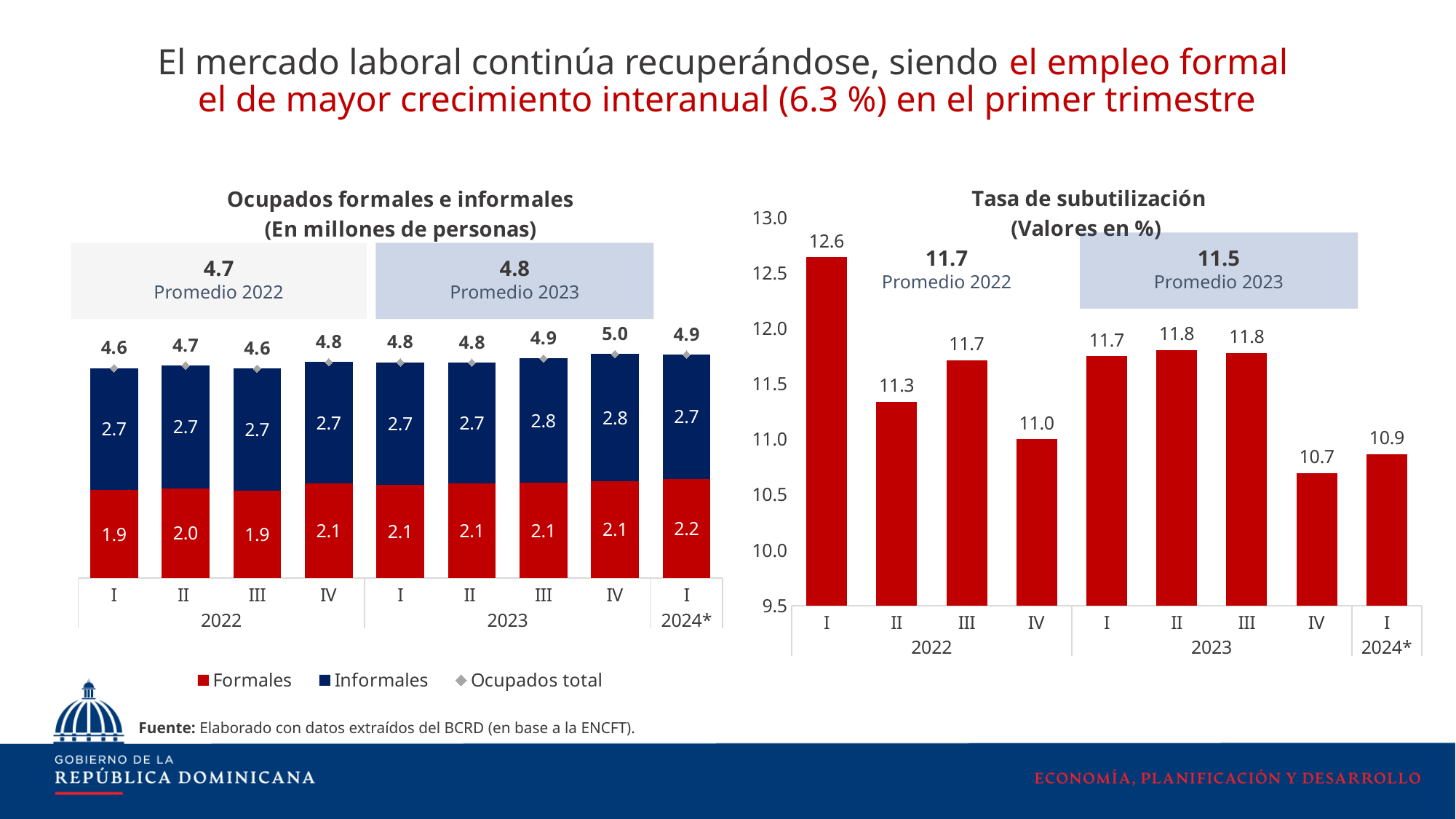
In the 'Tasa de subutilización' chart, how many quarters are plotted? 9 In the 'Ocupados formales e informales' chart, what is the difference between the Informales and Formales values in quarter I of 2022? 0.8 In the 'Ocupados formales e informales' chart, how many series does the legend list? 3 In the 'Tasa de subutilización' chart, what is the value for quarter I of 2024*? 10.9 In the 'Tasa de subutilización' chart, what is the difference between quarter I of 2022 and quarter IV of 2023? 1.9 In the 'Tasa de subutilización' chart, which quarter has the highest value? I 2022 What kind of chart is the 'Tasa de subutilización' chart? Bar chart In the 'Ocupados formales e informales' chart, what is the average (Promedio) shown for 2023? 4.8 In the 'Ocupados formales e informales' chart, what is the value for Formales in quarter I of 2024*? 2.2 In the 'Tasa de subutilización' chart, which quarter has the lowest value? IV 2023 In the 'Ocupados formales e informales' chart, what is the Ocupados total for quarter IV of 2023? 5.0 In the 'Ocupados formales e informales' chart, what is the value for Informales in quarter IV of 2023? 2.8